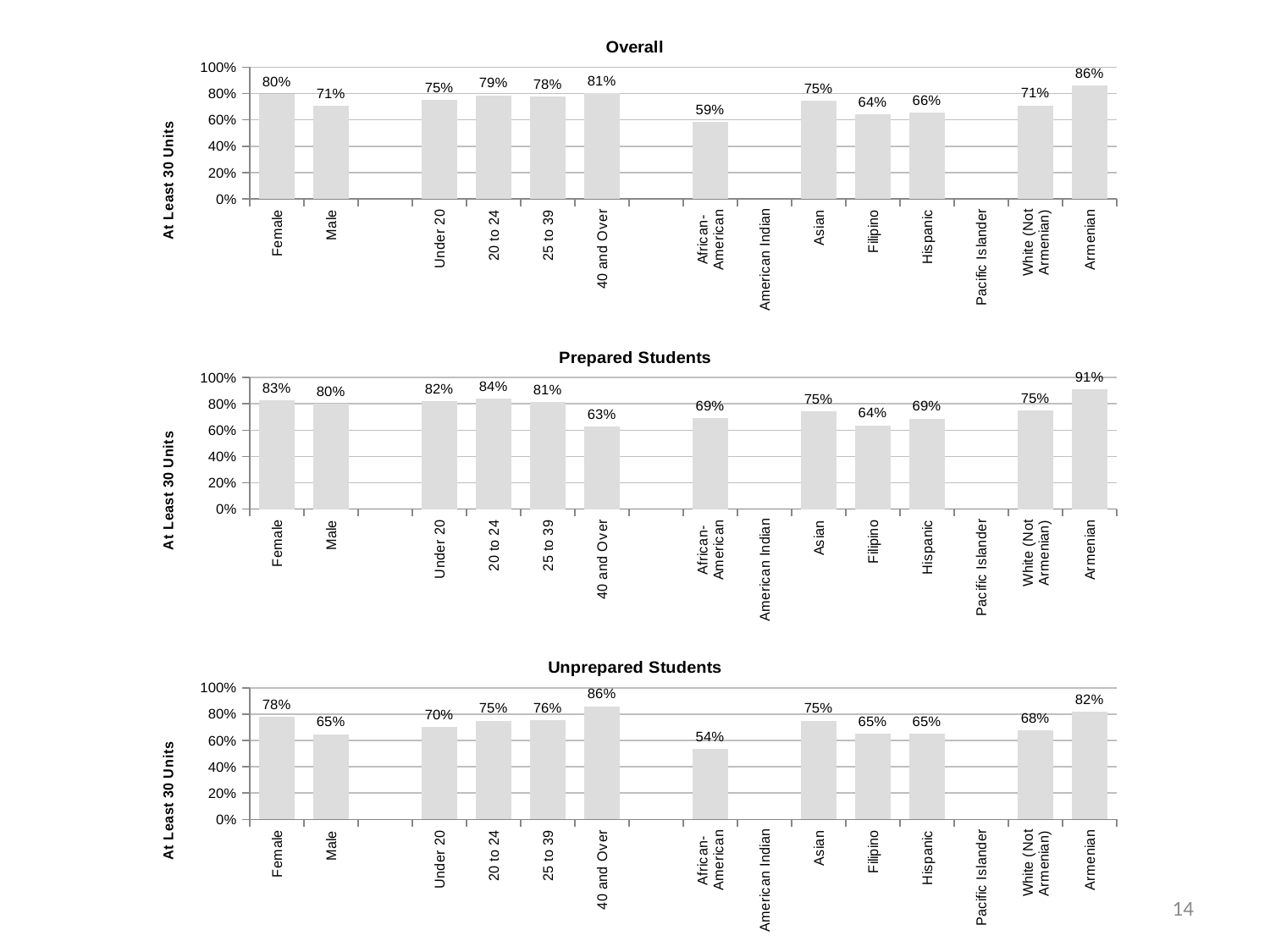
In the Prepared Students chart, which is larger, the value for Asian or the value for Filipino? Asian What kind of chart is the Overall chart? Bar chart In the Overall chart, what is the difference between the values for Female and Male? 9% In the Overall chart, what is the value for Female? 80% What is the y-axis label on the Prepared Students chart? At Least 30 Units In the Unprepared Students chart, which category has the highest value? 40 and Over In the Overall chart, which category has the highest value? Armenian In the Prepared Students chart, which category has the highest value? Armenian In the Unprepared Students chart, what is the difference between the values for Armenian and White (Not Armenian)? 14% In the Overall chart, which category has the lowest value among the bars shown? African-American In the Unprepared Students chart, what is the value for African-American? 54% In the Prepared Students chart, what is the value for 40 and Over? 63%